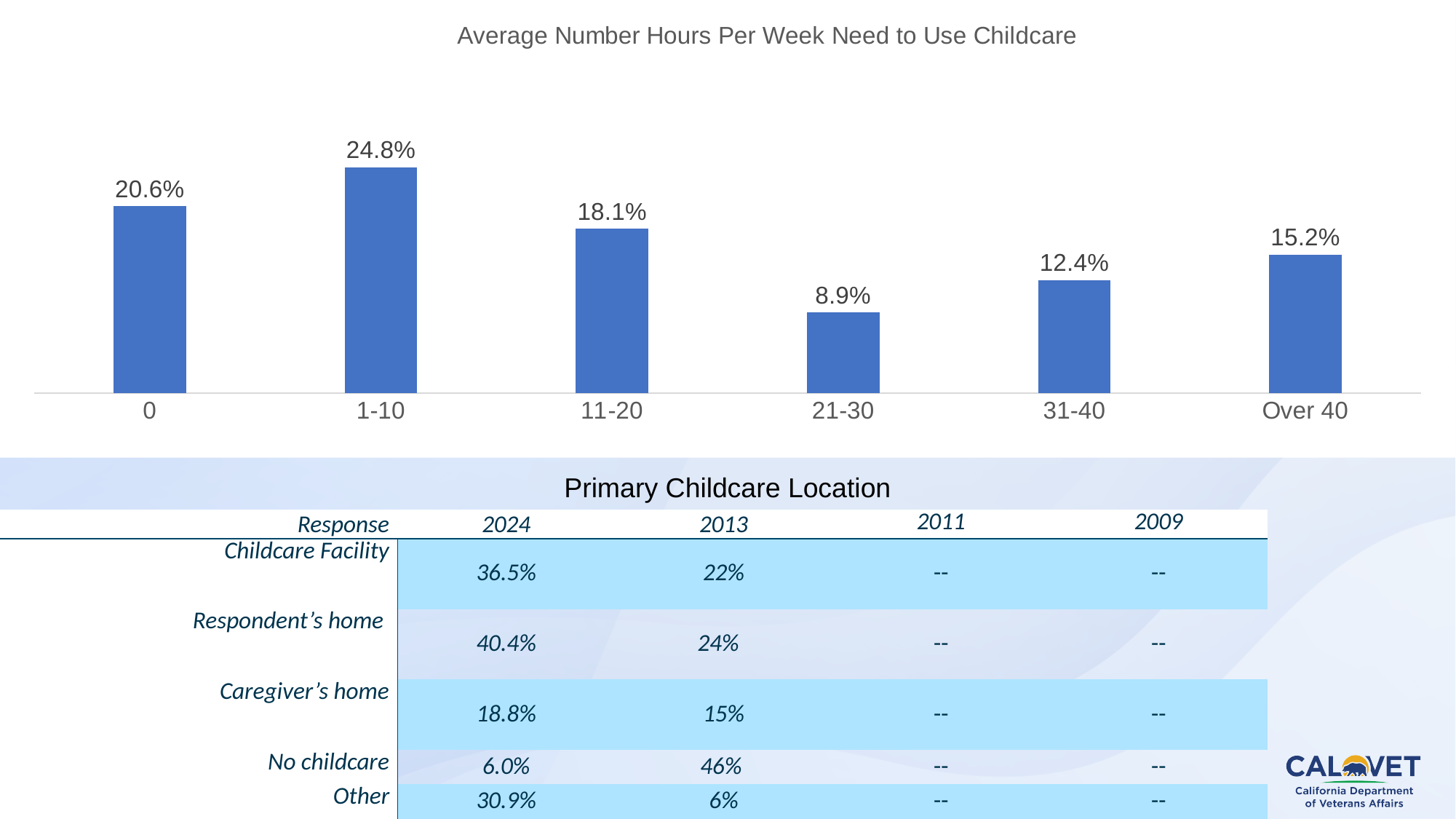
What is the value for the 21-30 category in the chart? 8.9% Which is larger in the chart, the value for 31-40 or the value for Over 40? Over 40 What is the value for the Over 40 category in the chart? 15.2% What is the title of the chart on the slide? Average Number Hours Per Week Need to Use Childcare How many categories are shown in the chart? 6 What is the difference between the values for 0 and 11-20 in the chart? 2.5% Which category has the lowest value in the chart? 21-30 Which category has the highest value in the chart? 1-10 What kind of chart is shown on the slide? Bar chart Do the values rise or fall from the 1-10 category to the 21-30 category in the chart? Fall What is the value for the 1-10 category in the Average Number Hours Per Week Need to Use Childcare chart? 24.8% What is the difference between the values for 1-10 and 21-30 in the chart? 15.9%